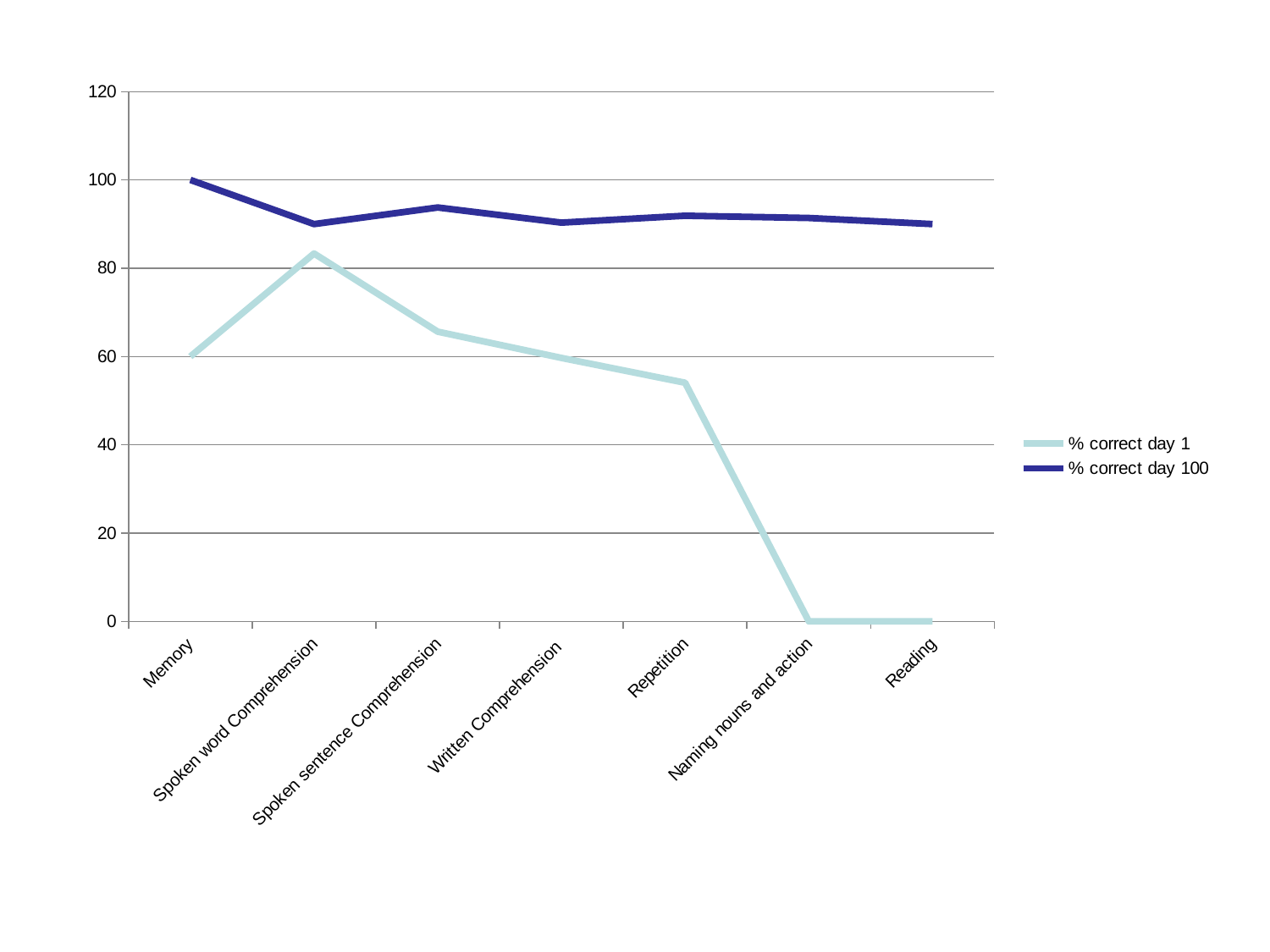
How many categories are plotted along the x axis? 7 What kind of chart is shown on the slide? line chart For Written Comprehension, which series has the larger value, % correct day 1 or % correct day 100? % correct day 100 Does the % correct day 1 line rise or fall from Repetition to Naming nouns and action? fall What is the value of % correct day 1 for Naming nouns and action? 0 Is the value of % correct day 1 for Repetition greater or less than 60? less Which category has the highest value for % correct day 100? Memory How many series does the legend list? 2 Which category has the highest value for % correct day 1? Spoken word Comprehension Is the value of % correct day 1 for Spoken word Comprehension greater or less than 80? greater What is the value of % correct day 1 for Reading? 0 What is the value of % correct day 100 for Memory? 100